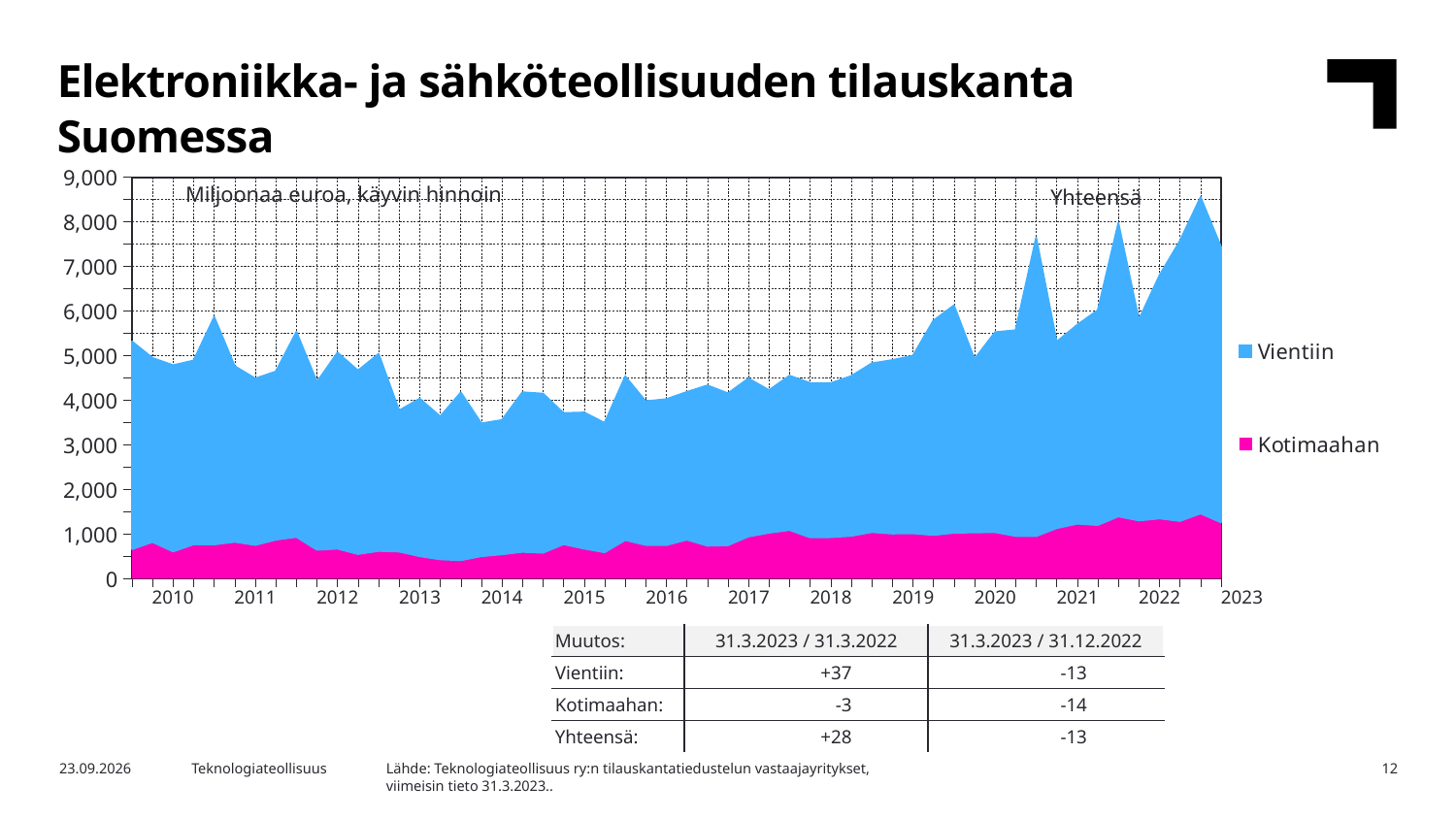
What are the two series named in the legend? Vientiin and Kotimaahan What unit is stated in the chart's subtitle text? Miljoonaa euroa, käyvin hinnoin Is the Kotimaahan value in 2010 greater or less than 1,000? less What kind of chart is shown on the slide? Stacked area chart Does the total order backlog rise or fall from 2019 to the end of 2022? Rise In which year does the total order backlog reach its highest point? 2022 How many series does the legend list? 2 Is the total value in early 2014 greater or less than 4,000? less Is the peak total value reached in late 2022 greater or less than 8,000? greater Which series is larger throughout the chart, Vientiin or Kotimaahan? Vientiin